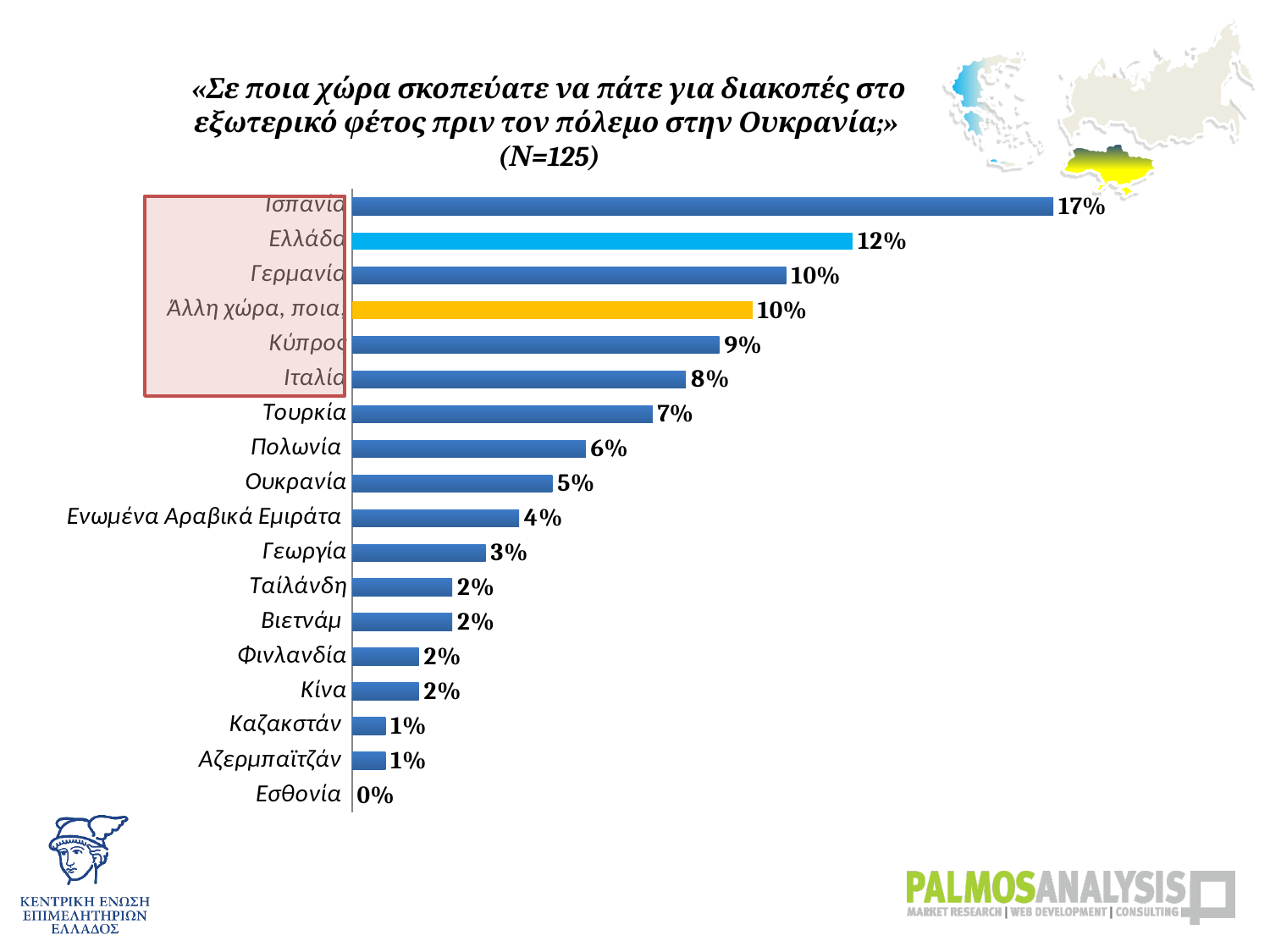
Which category has the lowest value? Εσθονία What is the value for Ελλάδα? 12% What is the value for Ισπανία? 17% Which is larger, the value for Τουρκία or the value for Πολωνία? Τουρκία What is the value for Ενωμένα Αραβικά Εμιράτα? 4% Which bar is coloured orange/yellow? Άλλη χώρα, ποια; What is the difference between the values for Ισπανία and Ελλάδα? 5% What is the value for Κύπρος? 9% How many categories are shown in the chart? 18 What is the sample size (N) stated in the chart title? 125 What kind of chart is shown on the slide? Bar chart Which country has the highest value? Ισπανία